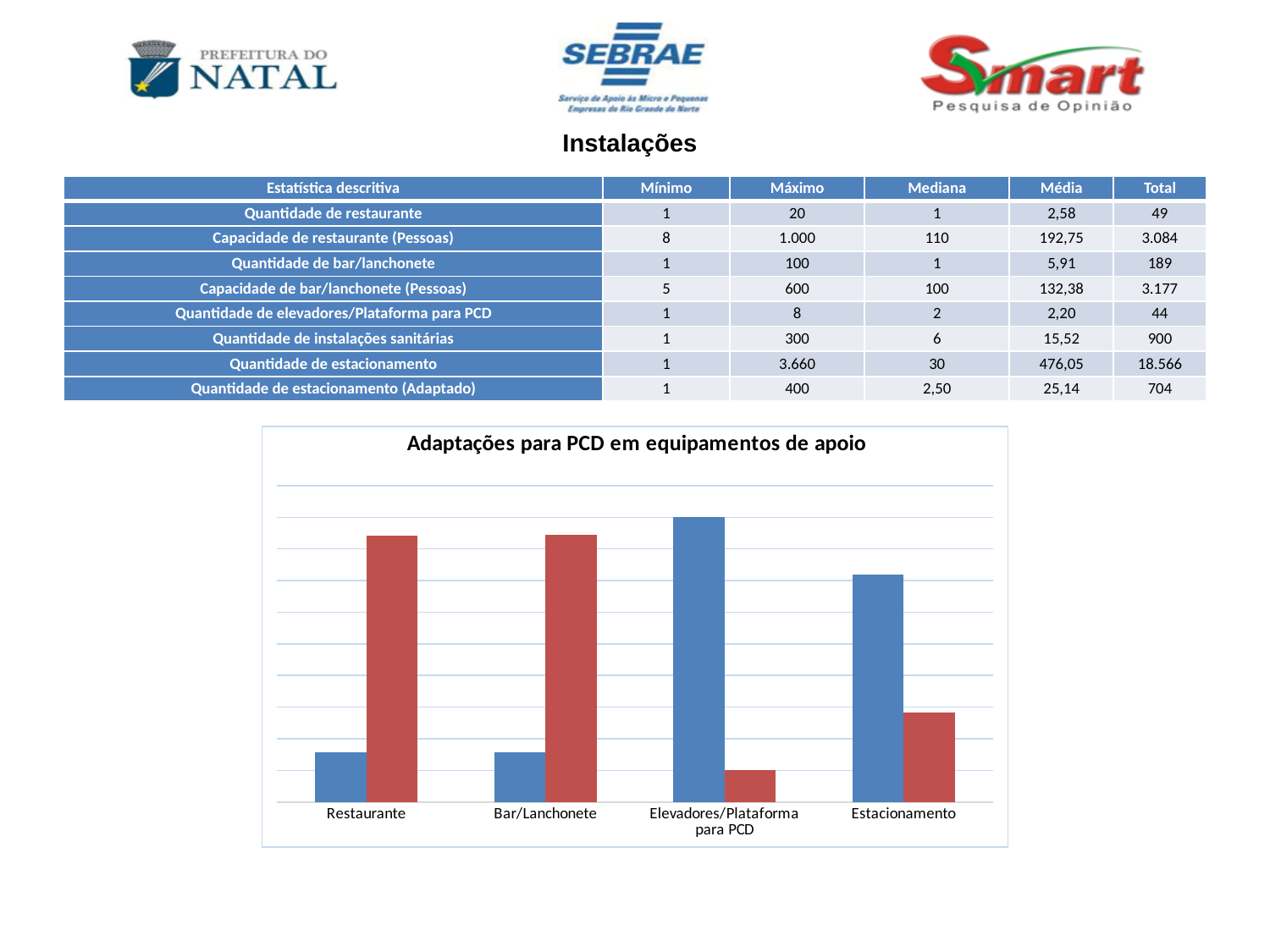
For Bar/Lanchonete, is the blue bar or the red bar taller? red Is the blue bar for Estacionamento taller or shorter than the blue bar for Elevadores/Plataforma para PCD? shorter What is the title of the chart on the slide? Adaptações para PCD em equipamentos de apoio What kind of chart is shown on the slide? bar chart Which category has the tallest blue bar in the chart? Elevadores/Plataforma para PCD How many bars are plotted for each category in the chart? 2 Which category has the shortest red bar in the chart? Elevadores/Plataforma para PCD For Restaurante, is the blue bar or the red bar taller? red How many categories are shown on the x axis of the chart? 4